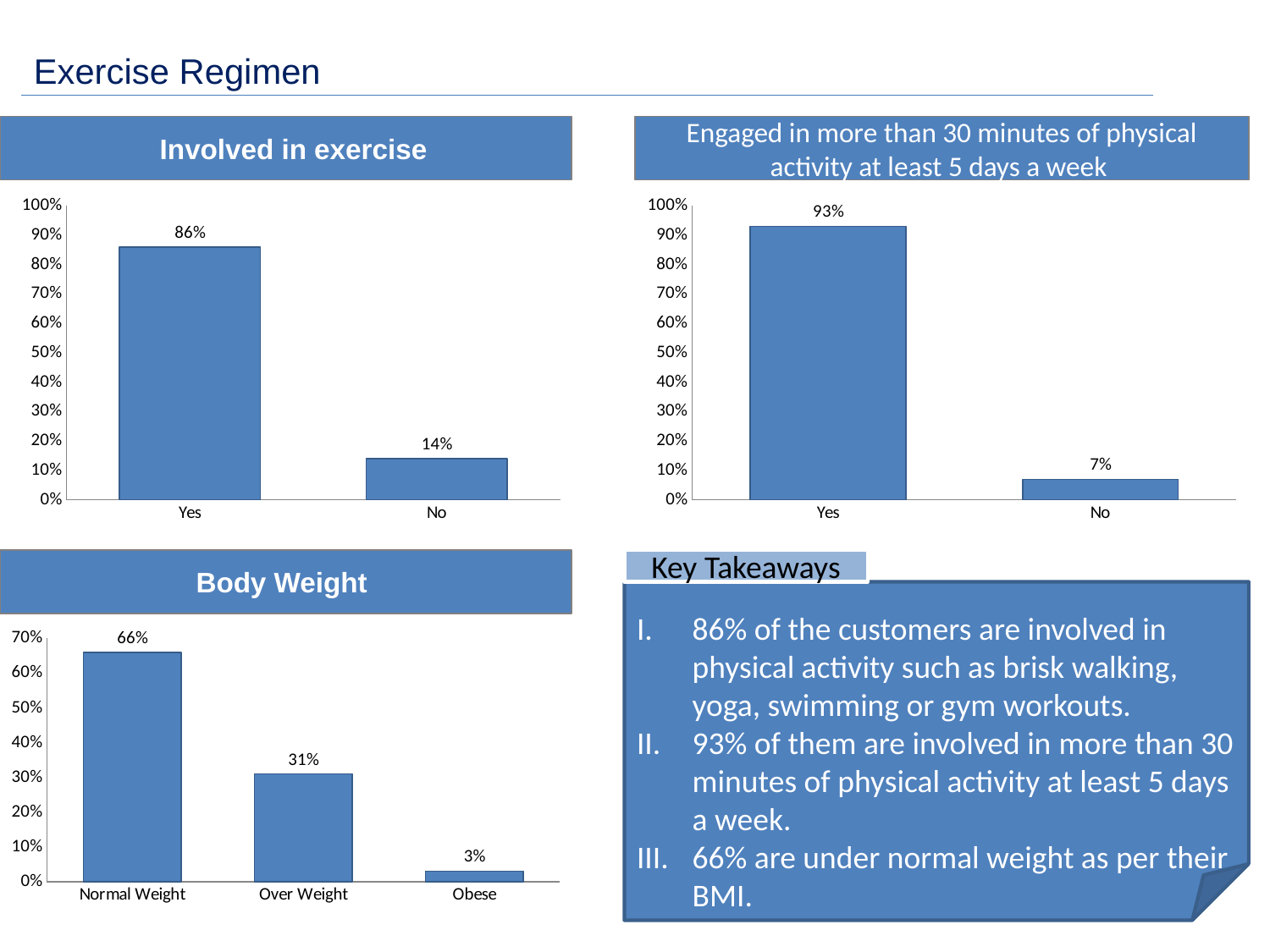
In the 'Body Weight' chart, what is the value for Over Weight? 31% In the 'Engaged in more than 30 minutes of physical activity at least 5 days a week' chart, what is the value for Yes? 93% In the 'Involved in exercise' chart, what is the value for No? 14% In the 'Body Weight' chart, what is the difference between Normal Weight and Over Weight? 35% What kind of chart is the 'Body Weight' chart? Bar chart In the 'Body Weight' chart, which category is highest? Normal Weight In the 'Engaged in more than 30 minutes of physical activity at least 5 days a week' chart, what is the value for No? 7% In the 'Engaged in more than 30 minutes of physical activity at least 5 days a week' chart, which category is lowest? No In the 'Body Weight' chart, what is the value for Obese? 3% In the 'Involved in exercise' chart, what is the value for Yes? 86% In the 'Body Weight' chart, how many categories are shown? 3 In the 'Involved in exercise' chart, what is the difference between the Yes and No values? 72%